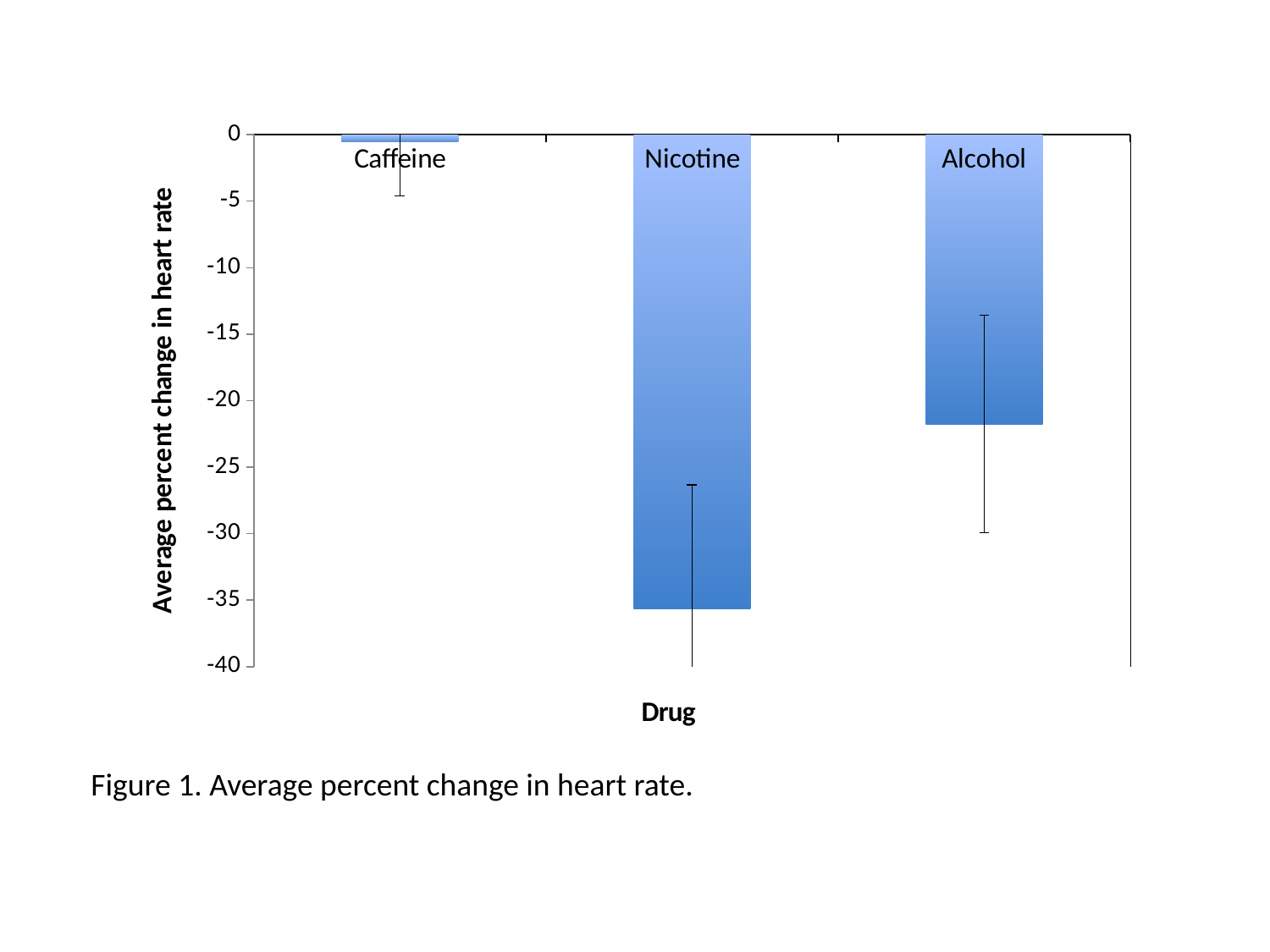
Which drug has the highest (closest to zero) average percent change in heart rate? Caffeine How many drug categories are plotted on the chart? 3 Which drug has the lowest (most negative) average percent change in heart rate? Nicotine What is the title of the x axis? Drug Is the value for Nicotine greater or less than -30? less What kind of chart is shown on the slide? bar chart Which bar extends further below zero, Nicotine or Alcohol? Nicotine Is the value for Alcohol greater or less than -25? greater Is the value for Alcohol greater or less than -20? less What is the title of the y axis? Average percent change in heart rate Which has the larger (less negative) value, Caffeine or Alcohol? Caffeine